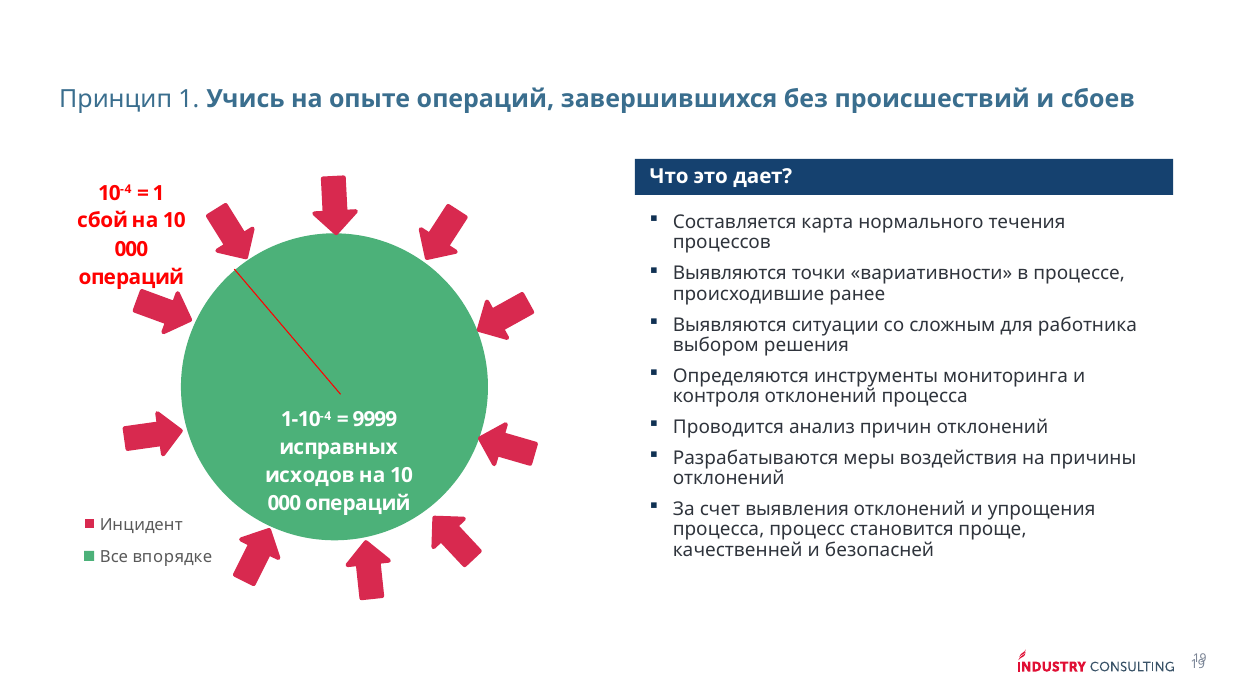
How many entries does the legend of the pie chart list? 2 What kind of chart is shown on the left of the slide? pie chart What colour represents the category Все впорядке in the pie chart? green According to the label on the pie chart, how many successful outcomes (исправных исходов) are there per 10 000 operations? 9999 According to the label next to the pie chart, how many failures (сбой) are there per 10 000 operations? 1 Which category has the smallest slice in the pie chart? Инцидент What colour represents the category Инцидент in the pie chart? red Which category has the largest slice in the pie chart? Все впорядке Which category takes up the larger part of the pie chart, Инцидент or Все впорядке? Все впорядке How many categories does the pie chart have? 2